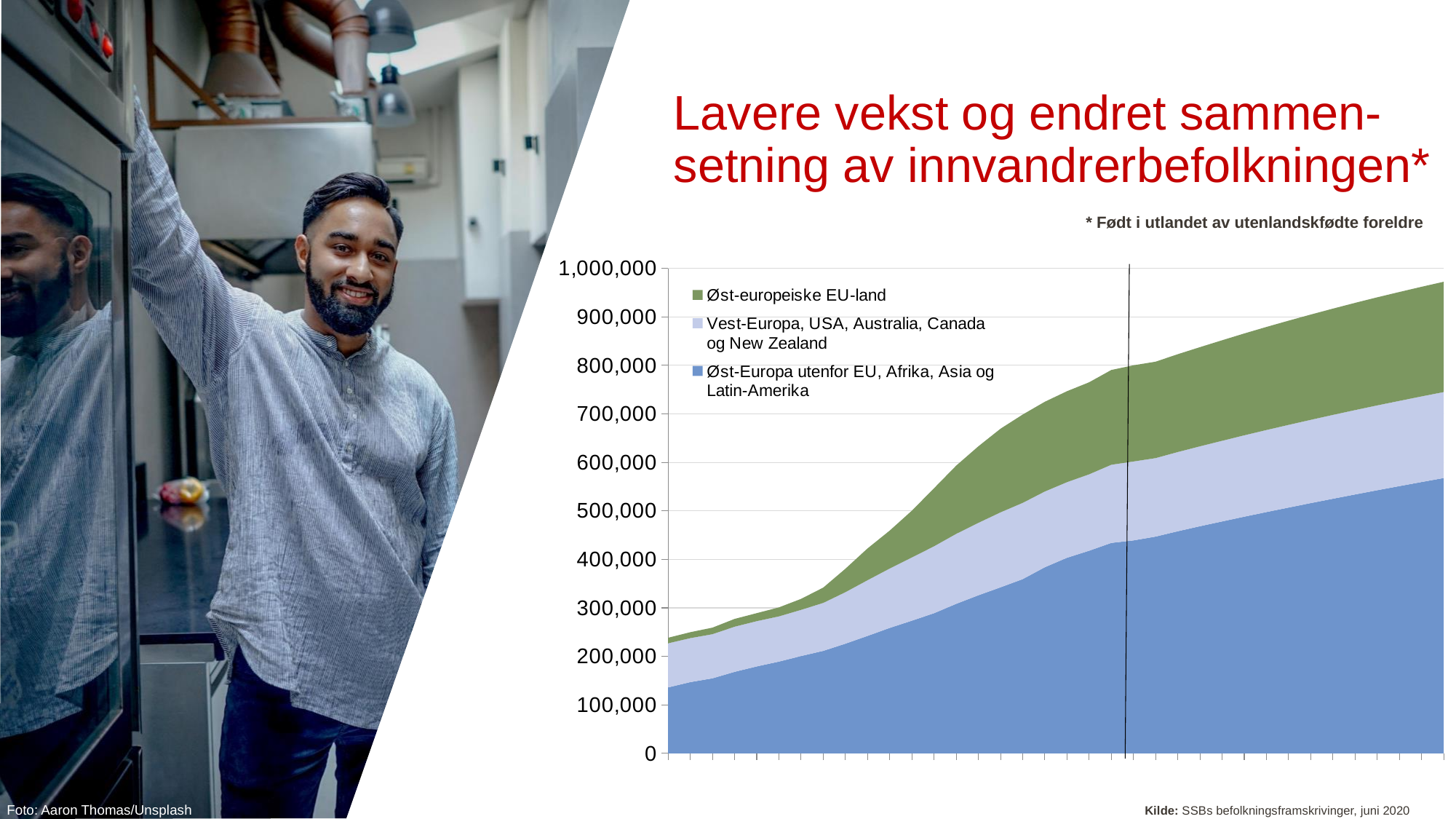
Which series has the smallest value at the left end of the chart? Øst-europeiske EU-land Is the total stacked value at the right end of the chart greater or less than 900,000? greater Which series is shown in green in the chart? Øst-europeiske EU-land Which series has the largest value at the right end of the chart? Øst-Europa utenfor EU, Afrika, Asia og Latin-Amerika Does the total stacked value rise or fall along the x axis? rise How many series does the chart's legend list? 3 At the right end of the chart, which is larger: the value for Øst-europeiske EU-land or the value for Øst-Europa utenfor EU, Afrika, Asia og Latin-Amerika? Øst-Europa utenfor EU, Afrika, Asia og Latin-Amerika Is the total stacked value at the left end of the chart greater or less than 300,000? less Is the value for Øst-Europa utenfor EU, Afrika, Asia og Latin-Amerika at the right end of the chart greater or less than 500,000? greater Which series is shown in dark blue at the bottom of the stacked area chart? Øst-Europa utenfor EU, Afrika, Asia og Latin-Amerika What kind of chart is shown on the slide? stacked area chart